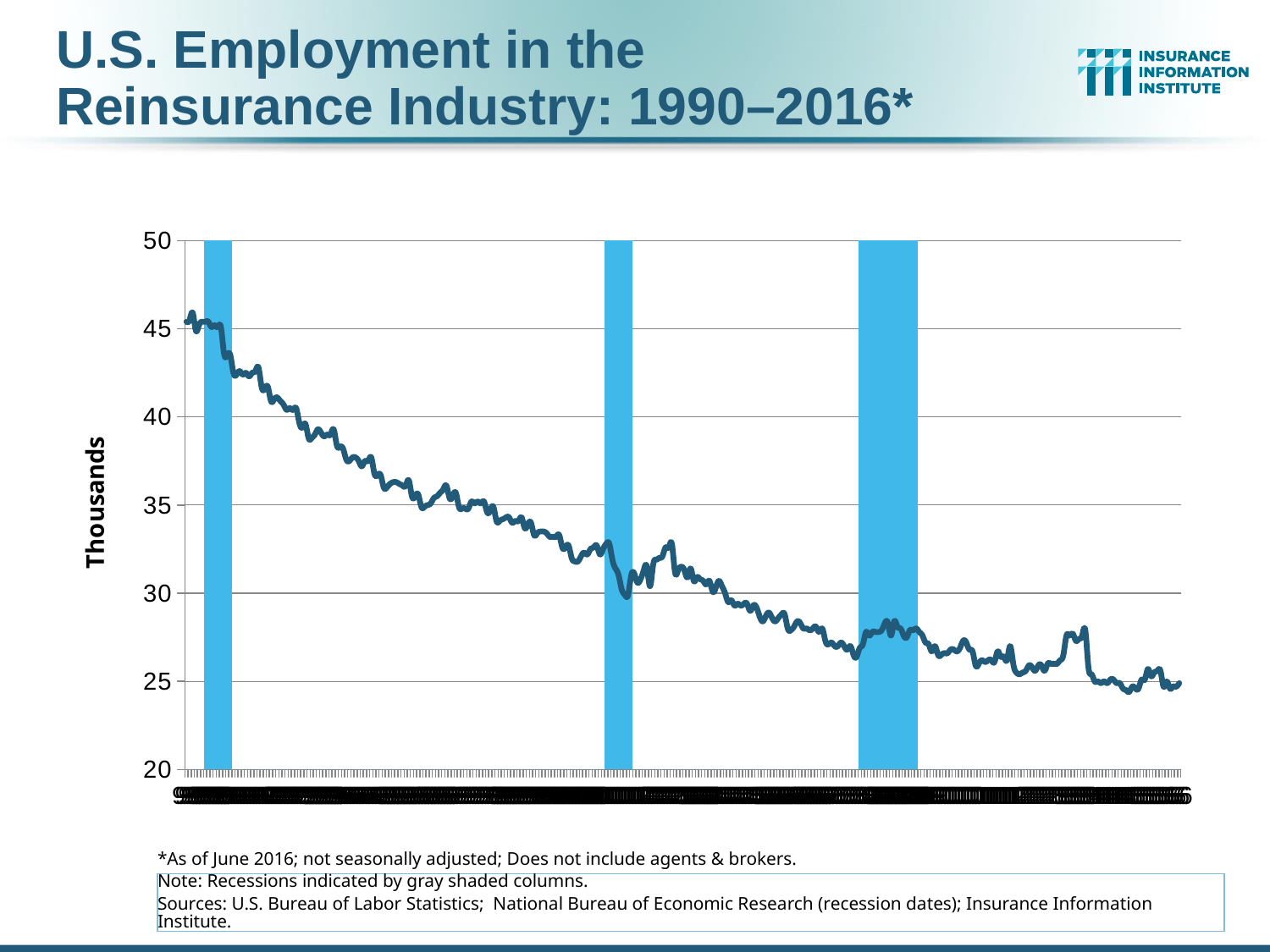
What is the label on the vertical axis? Thousands Is the value just before the second shaded recession band greater or less than 35? less Where along the x axis does the line reach its highest value, at the beginning or at the end of the period? at the beginning Is the value during the third shaded recession band greater or less than 25? greater How many shaded recession bands are shown on the chart? 3 Is the value at the end of the series (2016) greater or less than 30? less What is the title of the chart? U.S. Employment in the Reinsurance Industry: 1990–2016* What kind of chart is shown on the slide? line chart Which is larger, the value at the start of the series (1990) or the value at the end (2016)? the start (1990) Overall, do the values rise or fall from 1990 to 2016 along the x axis? fall